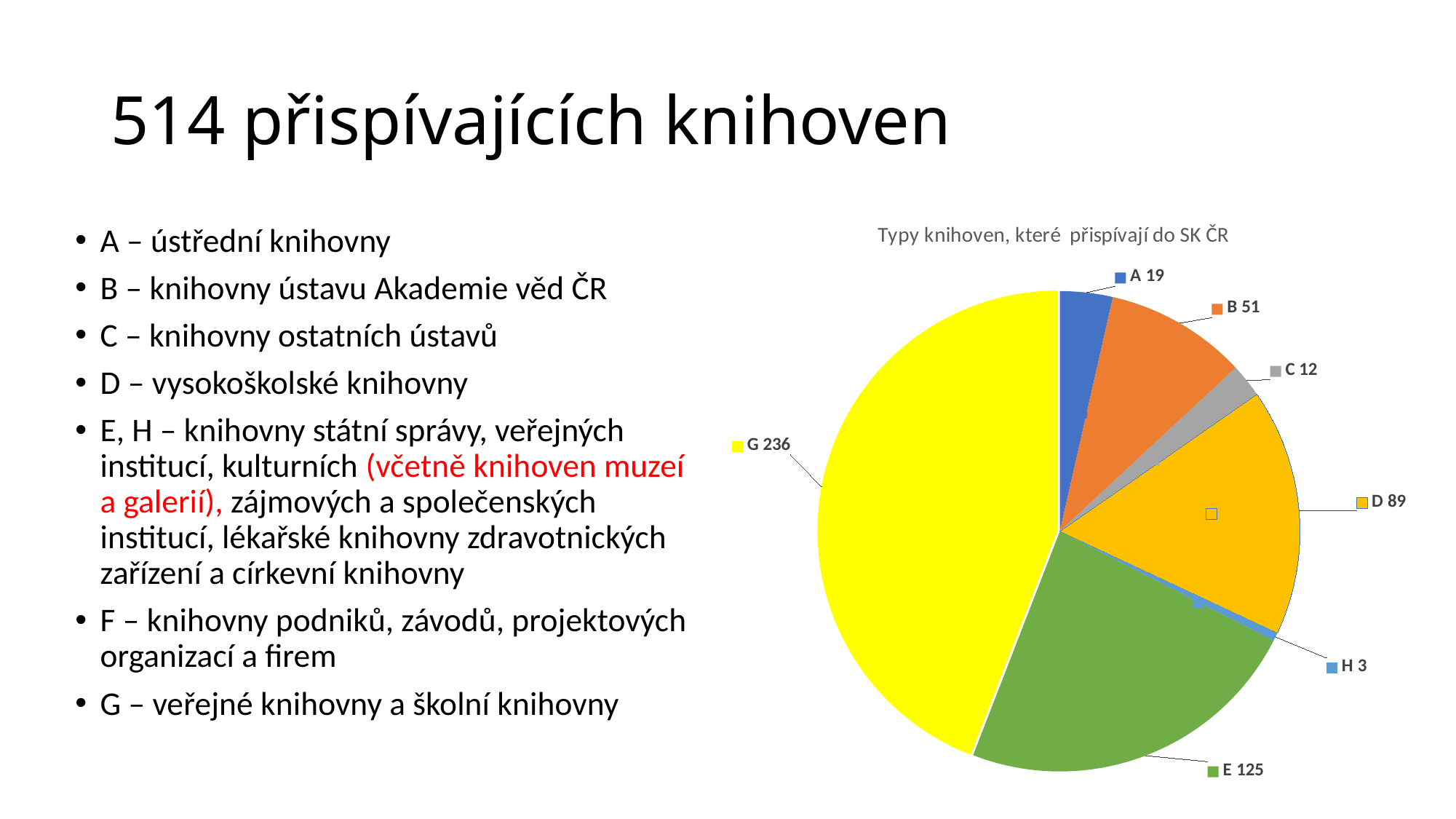
What is the difference between the values for E and D? 36 What is the value for category C in the pie chart? 12 What is the value for category D in the pie chart? 89 What kind of chart is shown on the slide? pie chart Which category has the smallest slice in the pie chart? H What is the value for category E in the pie chart? 125 What is the value for category G in the pie chart? 236 How many categories are labelled in the pie chart? 7 Which is larger, the value for B or the value for A? B What is the title of the pie chart? Typy knihoven, které přispívají do SK ČR Which category has the largest slice in the pie chart? G What is the difference between the values for G and E? 111